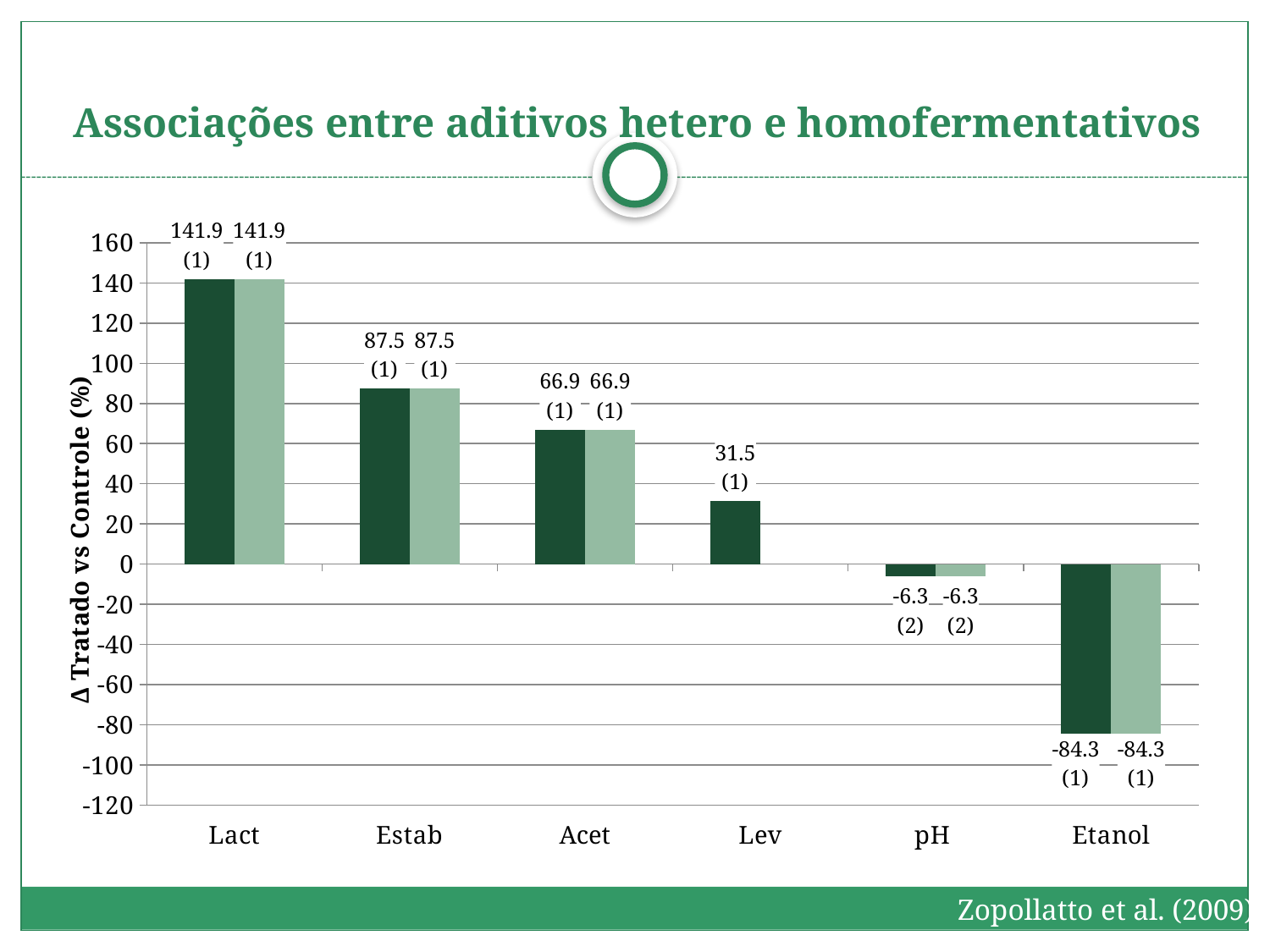
What is the value shown for Estab in the chart? 87.5 Which has the larger value, Acet or Lev? Acet What is the value shown for Etanol in the chart? -84.3 What kind of chart is shown on the slide? Bar chart What is the difference between the values for Lact and Estab? 54.4 What is the value shown for Lev in the chart? 31.5 What is the value shown for pH in the chart? -6.3 What is the value shown for Lact in the chart? 141.9 Which category has the highest value in the chart? Lact What is the title of the y axis of the chart? Δ Tratado vs Controle (%) Which category has the lowest value in the chart? Etanol How many categories are shown on the x axis of the chart? 6